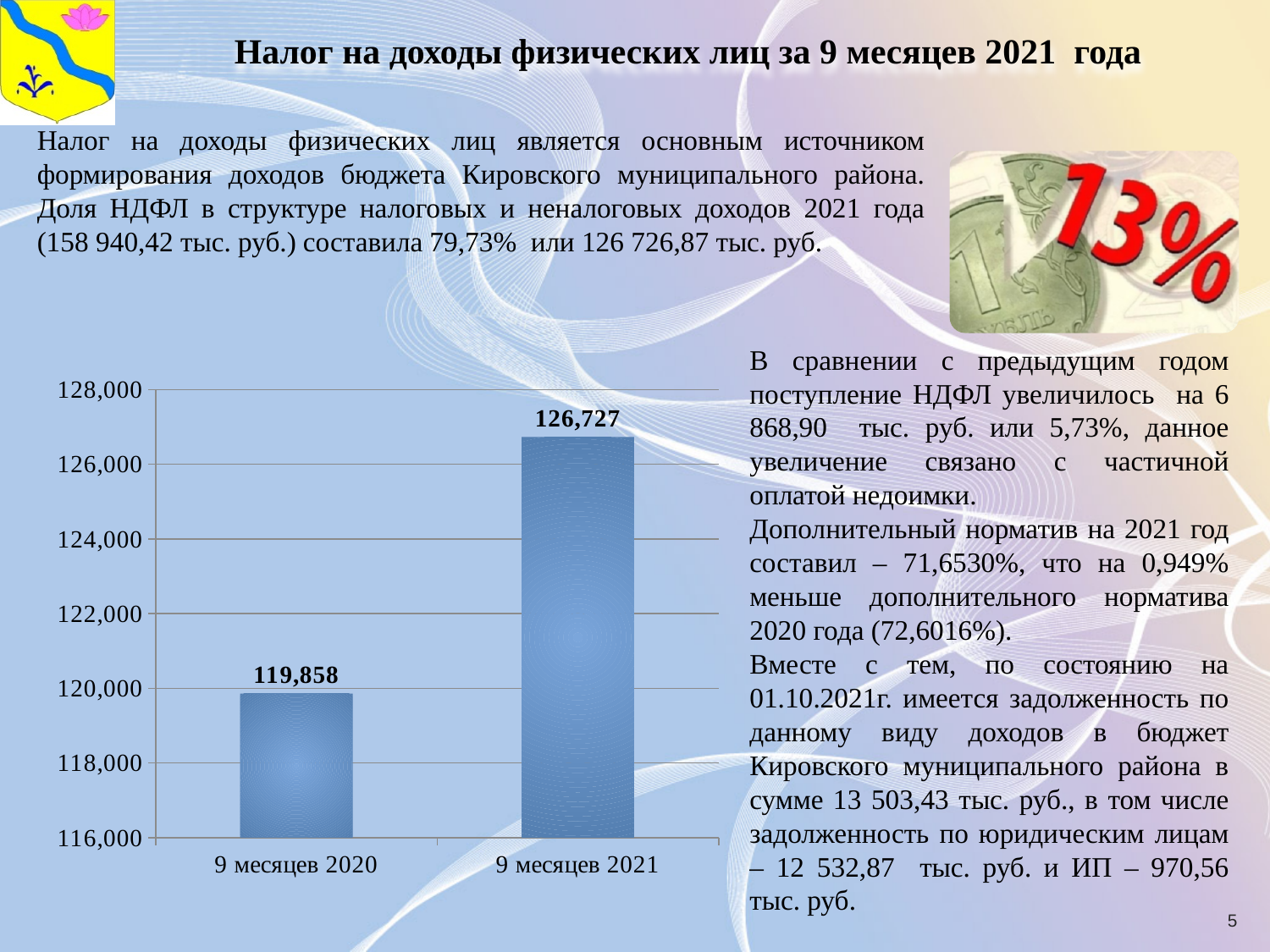
What is the lowest value shown on the vertical axis of the chart? 116,000 What is the difference between the values for 9 месяцев 2021 and 9 месяцев 2020? 6,869 What is the value for 9 месяцев 2021? 126,727 Which category has the highest value? 9 месяцев 2021 Is the value for 9 месяцев 2021 greater or less than 126,000? greater Is the value for 9 месяцев 2020 greater or less than 120,000? less What is the value for 9 месяцев 2020? 119,858 Which category has the lowest value? 9 месяцев 2020 Do the values rise or fall from 9 месяцев 2020 to 9 месяцев 2021? rise What kind of chart is shown on the slide? bar chart Which is larger, the value for 9 месяцев 2020 or the value for 9 месяцев 2021? 9 месяцев 2021 How many categories are shown on the chart? 2